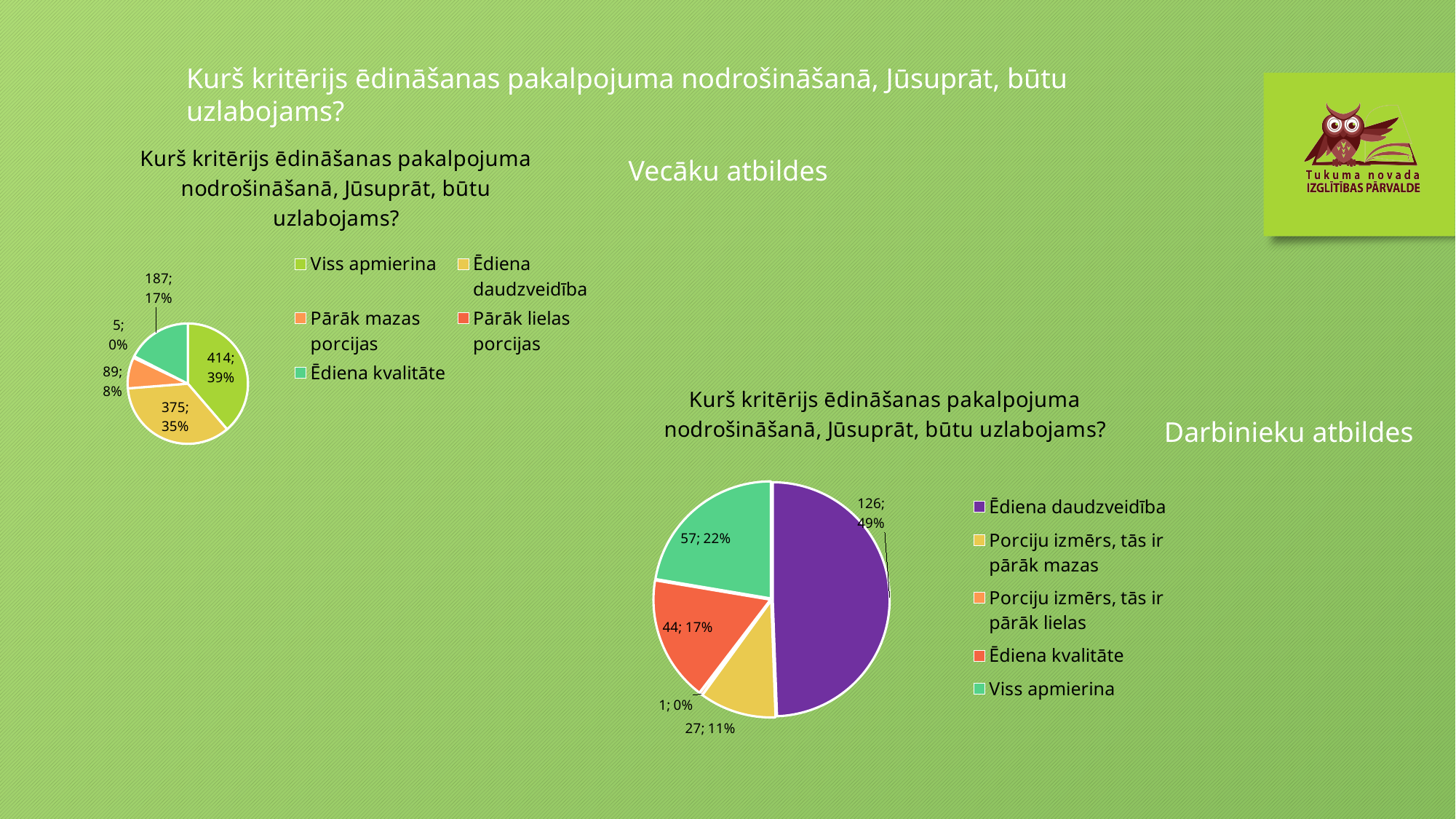
In the left pie chart (Vecāku atbildes), which category has the smallest slice? Pārāk lielas porcijas In the right pie chart (Darbinieku atbildes), which category has the largest slice? Ēdiena daudzveidība In the right pie chart (Darbinieku atbildes), what value is shown for Ēdiena daudzveidība? 126; 49% In the right pie chart (Darbinieku atbildes), what share of the pie does Viss apmierina take? 22% In the left pie chart (Vecāku atbildes), what value is shown for Viss apmierina? 414; 39% In the left pie chart (Vecāku atbildes), how many categories does the legend list? 5 In the right pie chart (Darbinieku atbildes), which is larger: Porciju izmērs, tās ir pārāk mazas or Ēdiena kvalitāte? Ēdiena kvalitāte In the right pie chart (Darbinieku atbildes), what is the difference in count between Viss apmierina and Ēdiena kvalitāte? 13 What colour is the Ēdiena daudzveidība slice in the right pie chart (Darbinieku atbildes)? purple What type of chart is used on the left (Vecāku atbildes) side of the slide? pie chart In the left pie chart (Vecāku atbildes), what share of the pie does Ēdiena daudzveidība take? 35% In the left pie chart (Vecāku atbildes), what value is shown for Ēdiena kvalitāte? 187; 17%